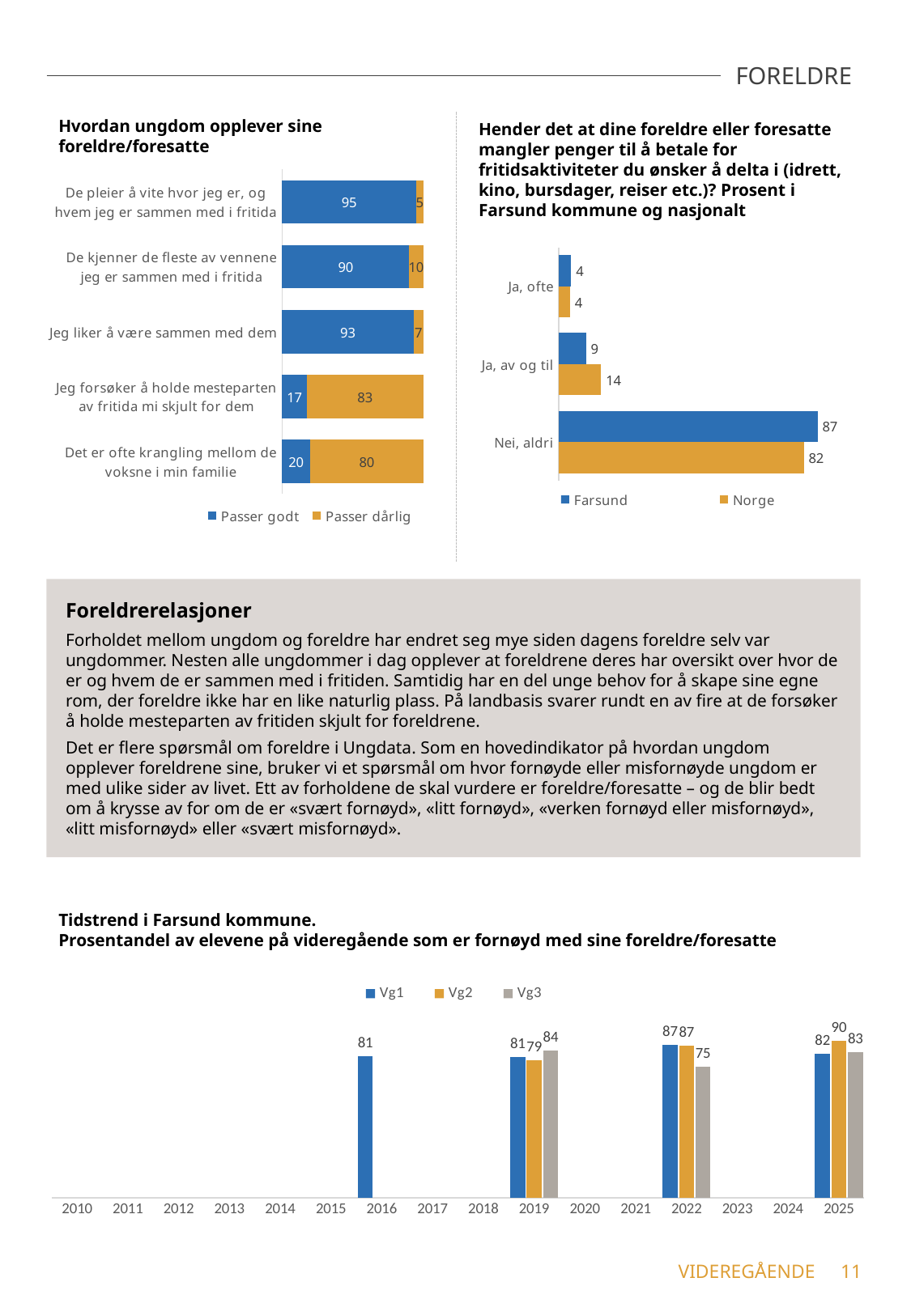
In the chart 'Hender det at dine foreldre eller foresatte mangler penger...', how many series does the legend list? 2 In the chart 'Hender det at dine foreldre eller foresatte mangler penger...', what is the Norge value for 'Ja, av og til'? 14 In the chart 'Tidstrend i Farsund kommune', which year has the lowest Vg3 value? 2022 In the chart 'Hvordan ungdom opplever sine foreldre/foresatte', how many categories are shown? 5 In the chart 'Hvordan ungdom opplever sine foreldre/foresatte', which category has the highest 'Passer dårlig' value? Jeg forsøker å holde mesteparten av fritida mi skjult for dem In the chart 'Tidstrend i Farsund kommune', what is the Vg2 value for 2025? 90 In the chart 'Hender det at dine foreldre eller foresatte mangler penger...', what is the difference between the Farsund and Norge values for 'Nei, aldri'? 5 What kind of chart is 'Tidstrend i Farsund kommune'? Bar chart In the chart 'Hvordan ungdom opplever sine foreldre/foresatte', what is the 'Passer godt' value for 'De pleier å vite hvor jeg er, og hvem jeg er sammen med i fritida'? 95 In the chart 'Hvordan ungdom opplever sine foreldre/foresatte', what is the total of the stacked bar for 'De kjenner de fleste av vennene jeg er sammen med i fritida'? 100 In the chart 'Hvordan ungdom opplever sine foreldre/foresatte', which series does the legend list first? Passer godt In the chart 'Hender det at dine foreldre eller foresatte mangler penger...', which is larger for 'Ja, av og til': Farsund or Norge? Norge